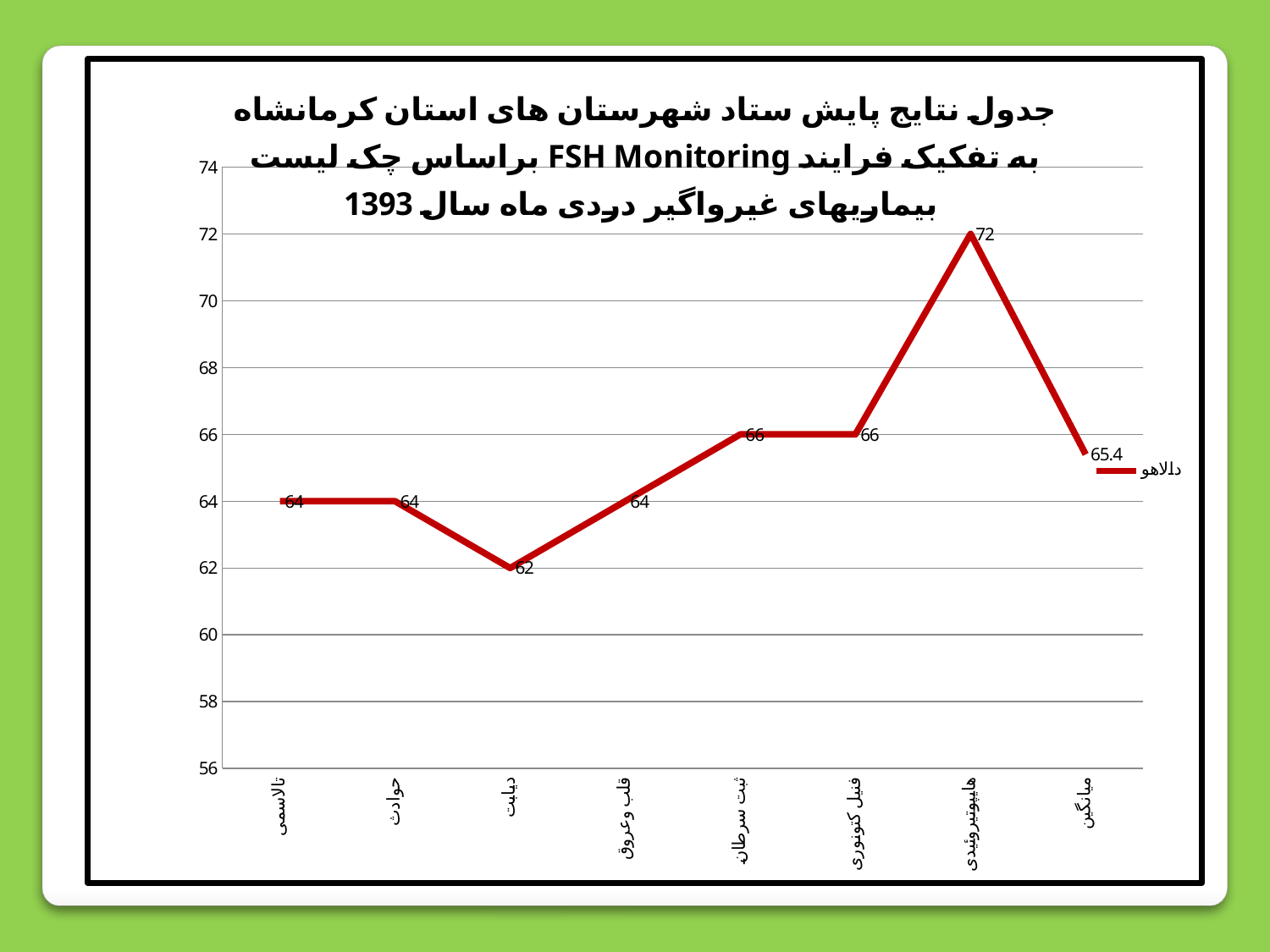
How many categories are plotted on the x axis? 8 What is the value for ثبت سرطان? 66 What is the value for دیابت? 62 Which category has the lowest value? دیابت Which is larger, the value for فنیل کتونوری or the value for قلب وعروق? فنیل کتونوری Is the value for هایپوتیروئیدی greater or less than 70? greater What type of chart is shown on the slide? line chart Which category has the highest value? هایپوتیروئیدی What is the value for میانگین? 65.4 What is the value for هایپوتیروئیدی? 72 What is the difference between the values for هایپوتیروئیدی and دیابت? 10 What series name does the legend show? دالاهو